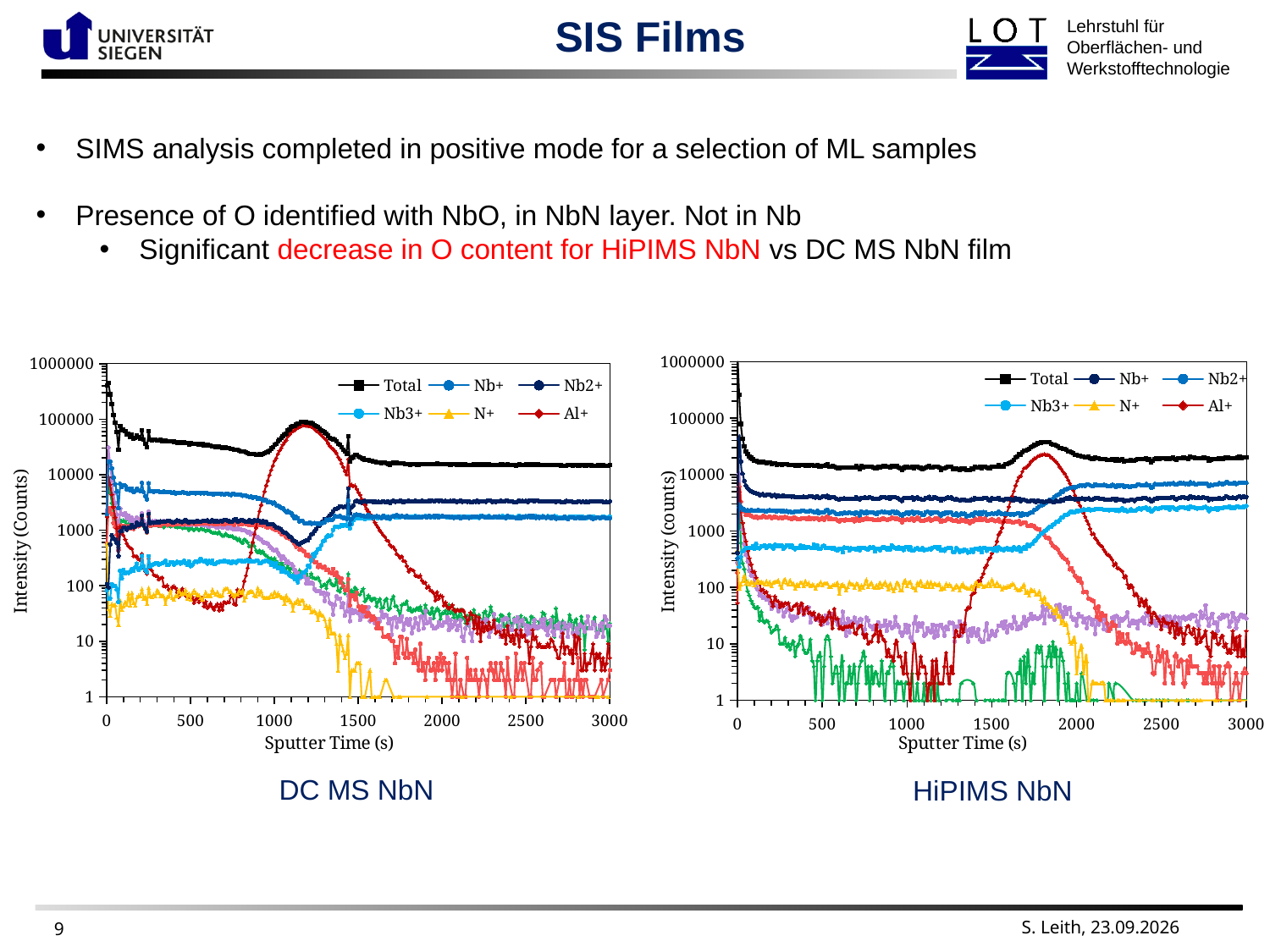
In the DC MS NbN chart, is the Nb+ intensity at 3000 s greater or less than 1000? greater Which chart shows the higher peak Al+ intensity, DC MS NbN or HiPIMS NbN? DC MS NbN What is the x-axis label of the HiPIMS NbN chart? Sputter Time (s) In the DC MS NbN chart, is the Total intensity at 3000 s greater or less than 10000? greater In the HiPIMS NbN chart, which series has the highest intensity across the whole sputter time range? Total In the DC MS NbN chart, which series has the highest intensity across the whole sputter time range? Total What kind of chart is the DC MS NbN chart? line chart How many series does the legend of the HiPIMS NbN chart list? 6 In the HiPIMS NbN chart, is the Total intensity at 3000 s greater or less than 10000? greater How many series does the legend of the DC MS NbN chart list? 6